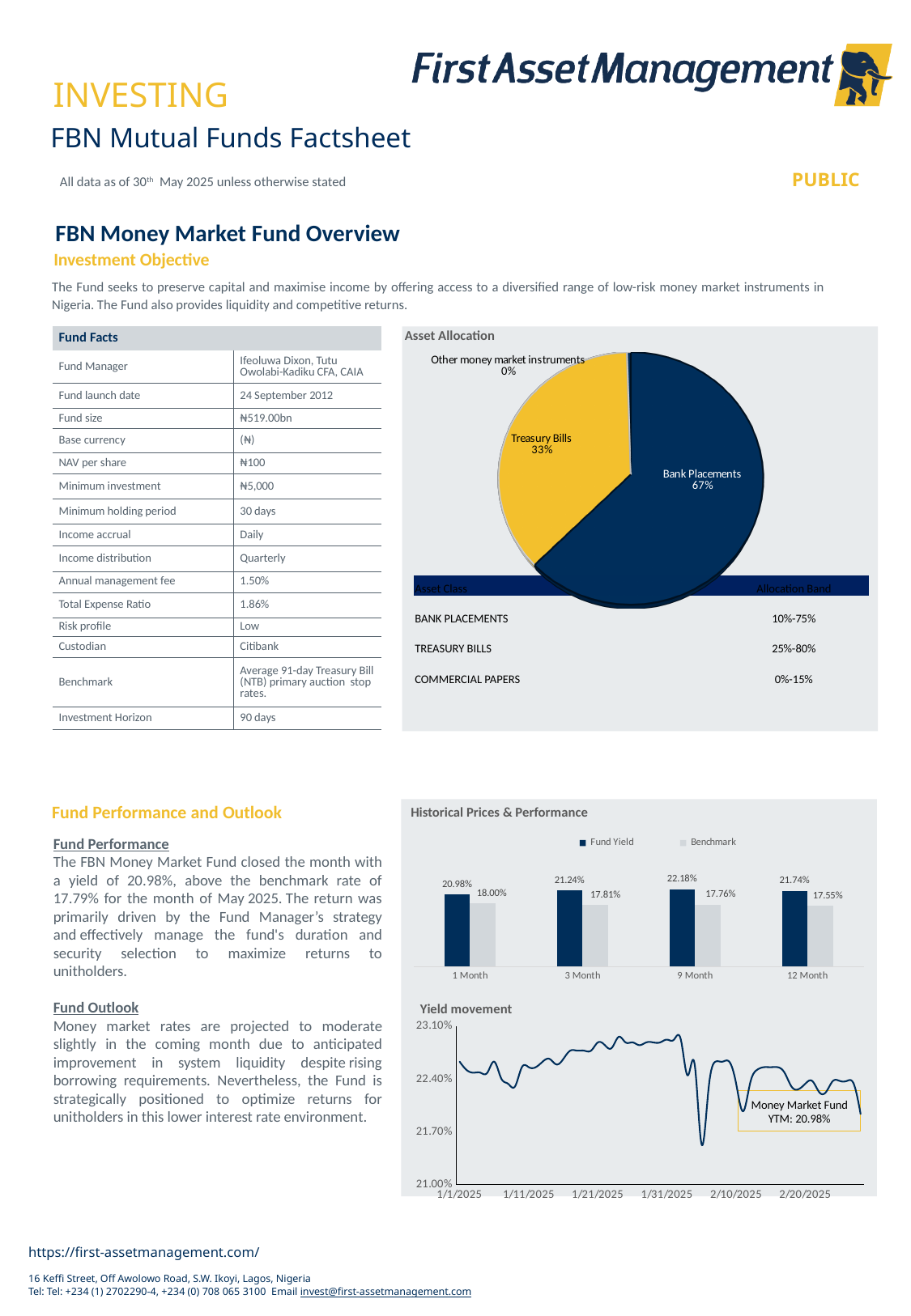
What kind of chart is the Asset Allocation chart? Pie chart In the Yield movement chart, what YTM value is shown in the annotation for the Money Market Fund? 20.98% In the Historical Prices & Performance chart, how many periods are shown on the x axis? 4 In the Historical Prices & Performance chart, how many series does the legend list? 2 In the Historical Prices & Performance chart, which period has the highest Fund Yield? 9 Month In the Historical Prices & Performance chart, what is the Benchmark value for 12 Month? 17.55% In the Historical Prices & Performance chart, what is the difference between the Fund Yield and the Benchmark for 1 Month? 2.98% In the Historical Prices & Performance chart, what is the Fund Yield for 9 Month? 22.18% In the Asset Allocation pie chart, what share of the fund is in Treasury Bills? 33% In the Asset Allocation pie chart, what share of the fund is in Bank Placements? 67% What kind of chart is the Yield movement chart? Line chart In the Asset Allocation pie chart, which slice is the largest? Bank Placements